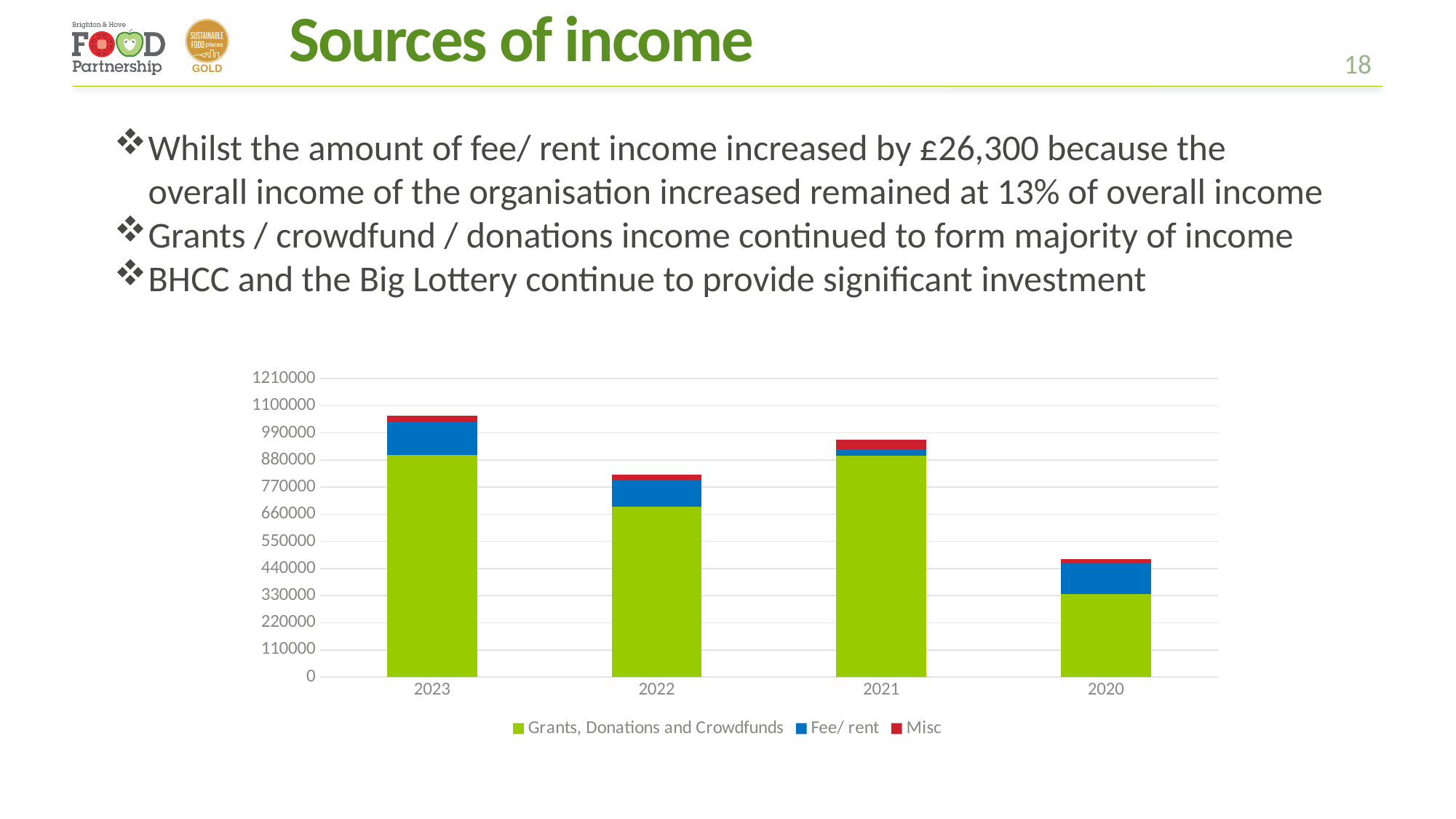
Which series is shown in green in the chart? Grants, Donations and Crowdfunds Is the total income bar for 2021 greater or less than 990000? less Is the total income bar for 2023 greater or less than 990000? greater Which year has the highest total income bar? 2023 How many years are shown on the x axis of the chart? 4 Is the Grants, Donations and Crowdfunds segment for 2020 greater or less than 440000? less Which year has the larger total income bar, 2022 or 2021? 2021 How many series does the chart legend list? 3 What kind of chart is shown on the slide? Stacked bar chart Which year has the larger Fee/ rent segment, 2020 or 2021? 2020 Which year has the lowest total income bar? 2020